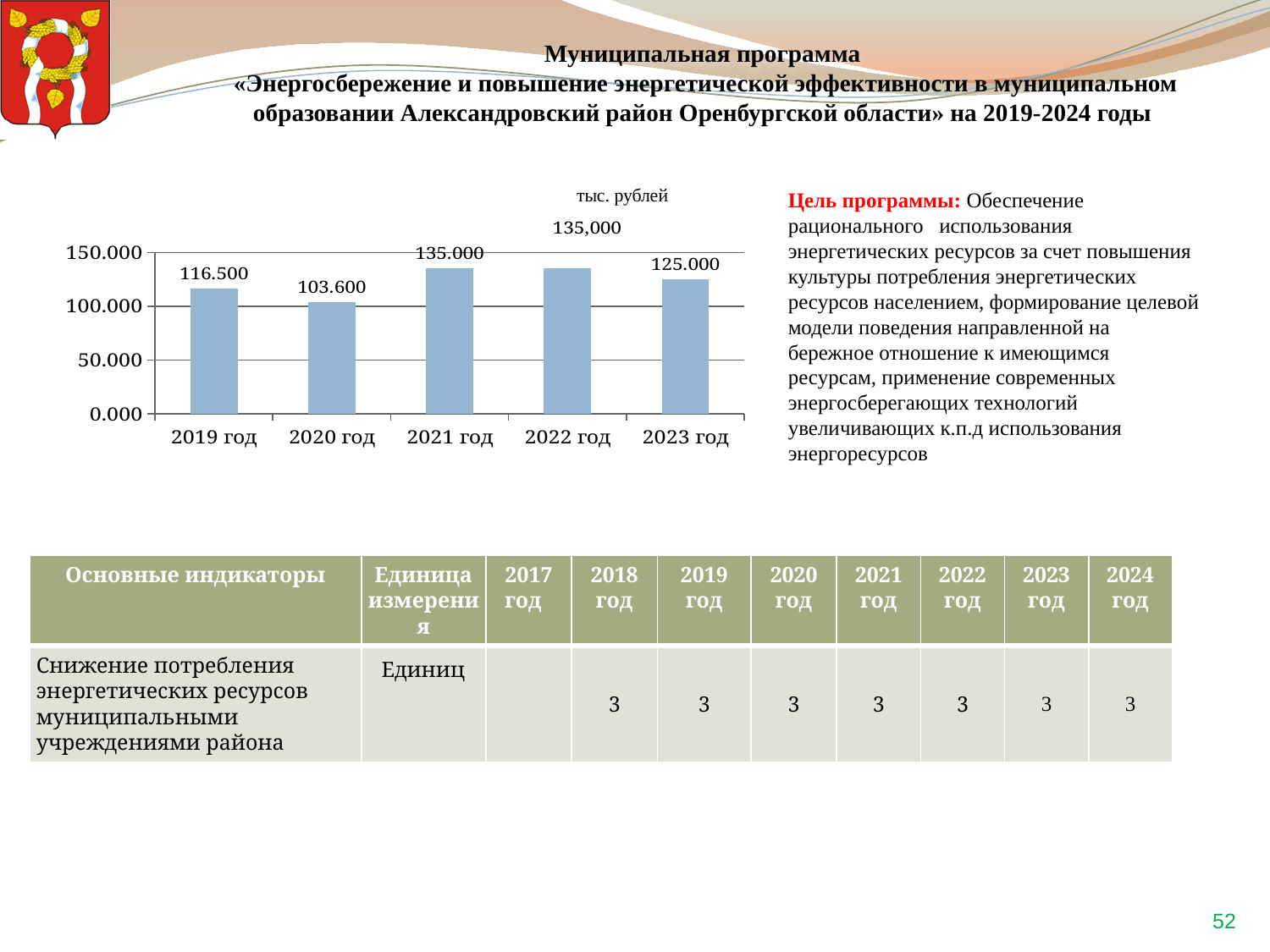
What is the value for 2023 год? 125.000 What is the value for 2021 год? 135.000 What is the value for 2019 год? 116.500 Is the value for 2021 год greater or less than 100.000? greater What is the difference between the values for 2021 год and 2023 год? 10.000 What unit is indicated above the chart? тыс. рублей What is the value for 2020 год? 103.600 How many years are shown on the x axis of the chart? 5 Which is larger, the value for 2019 год or 2023 год? 2023 год Which year has the lowest value? 2020 год What is the difference between the values for 2019 год and 2020 год? 12.900 What kind of chart is shown on the slide? bar chart